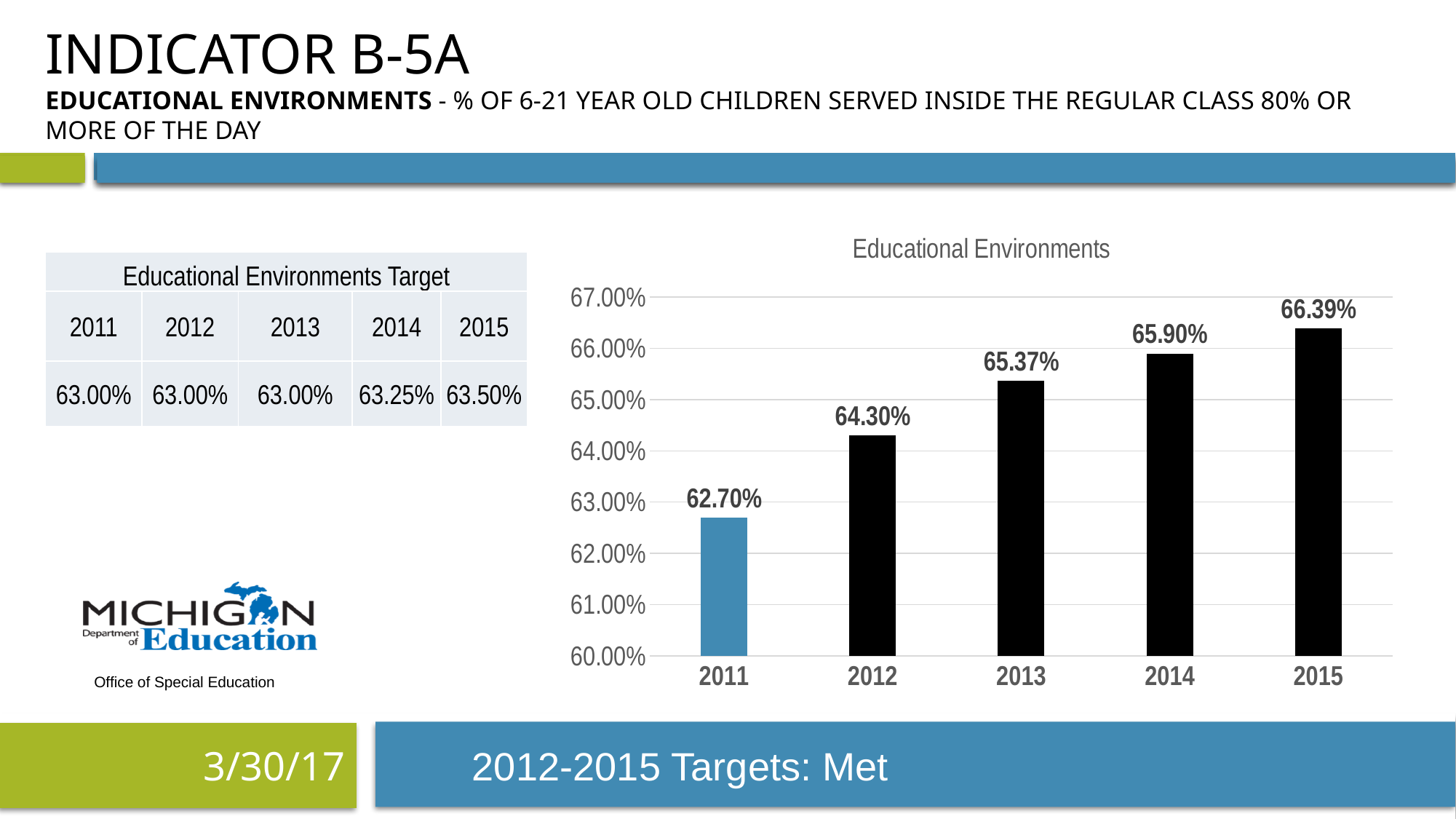
What kind of chart is the Educational Environments chart? bar chart What is the difference between the 2015 and 2011 values in the Educational Environments chart? 3.69% How many years are shown on the x axis of the Educational Environments chart? 5 What is the value for 2015 in the Educational Environments chart? 66.39% Is the value for 2012 in the Educational Environments chart greater or less than 64.00%? greater What is the difference between the 2014 and 2013 values in the Educational Environments chart? 0.53% Which year has the highest value in the Educational Environments chart? 2015 What is the value for 2013 in the Educational Environments chart? 65.37% Which is larger in the Educational Environments chart, the value for 2012 or the value for 2014? 2014 What is the value for 2011 in the Educational Environments chart? 62.70% Which year has the lowest value in the Educational Environments chart? 2011 Do the values in the Educational Environments chart rise or fall from 2011 to 2015? rise